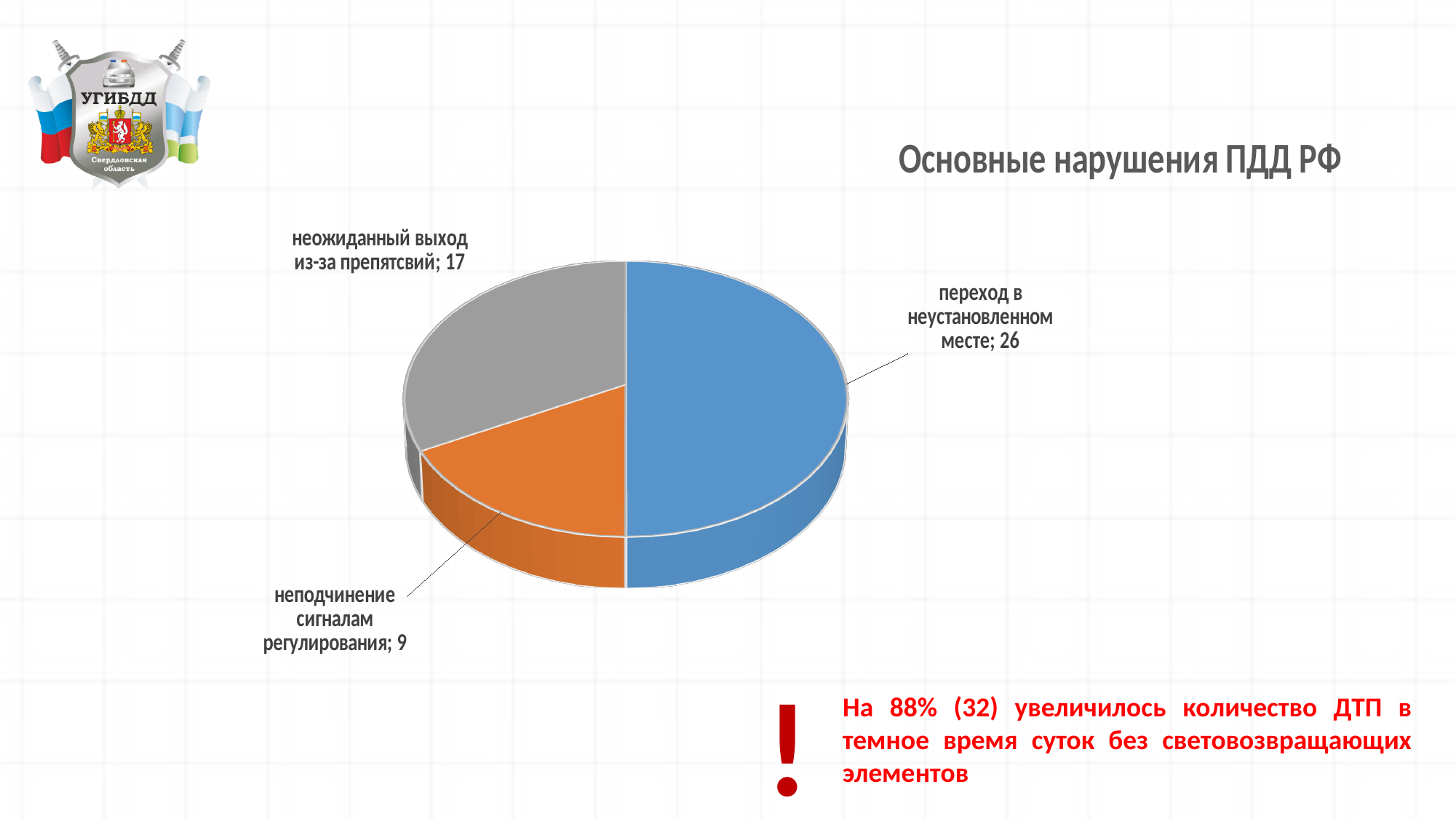
What is the value for «неподчинение сигналам регулирования»? 9 Which is larger: «неожиданный выход из-за препятсвий» or «неподчинение сигналам регулирования»? неожиданный выход из-за препятсвий What type of chart is shown on the slide? pie chart Which category has the largest slice of the pie? переход в неустановленном месте What is the value for «переход в неустановленном месте»? 26 Which category has the smallest slice of the pie? неподчинение сигналам регулирования What is the value for «неожиданный выход из-за препятсвий»? 17 What is the difference between the values for «переход в неустановленном месте» and «неожиданный выход из-за препятсвий»? 9 What is the difference between the values for «неожиданный выход из-за препятсвий» and «неподчинение сигналам регулирования»? 8 How many categories are shown in the pie chart? 3 What share of the pie does «переход в неустановленном месте» represent? 50% What is the title of the chart? Основные нарушения ПДД РФ